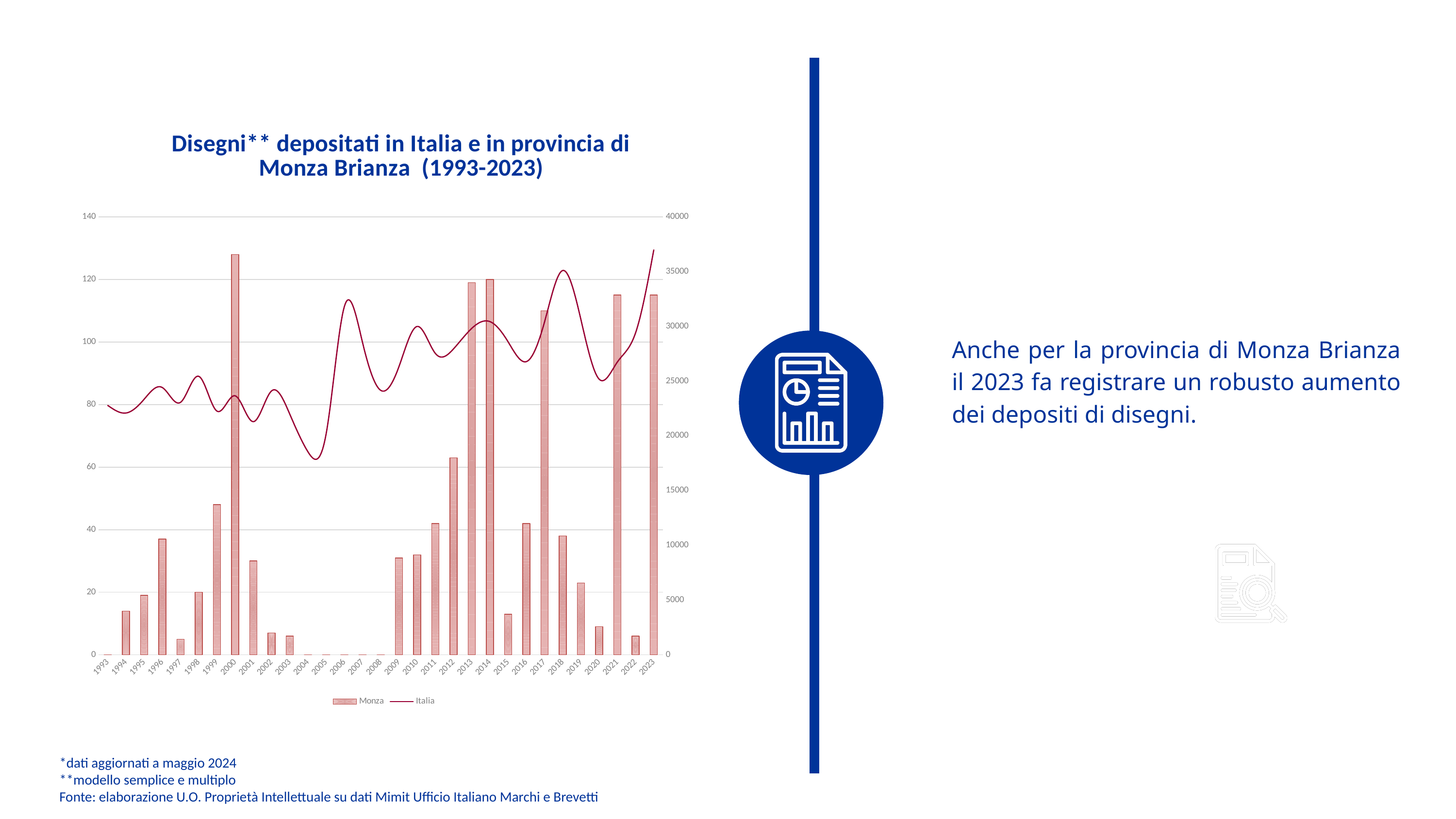
In which year does the Italia line reach its highest point? 2023 Is the Monza value for 2000 greater or less than 120? greater Is the Italia value for 2023 greater or less than 35000? greater How many series does the legend list? 2 In which year is the Monza bar the highest? 2000 Does the Italia line rise or fall from 2020 to 2023? Rise How many years are shown on the x axis? 31 Which two series are listed in the legend? Monza and Italia Which year has the larger Monza bar, 1996 or 2019? 1996 In which year does the Italia line reach its lowest point? 2004 What kind of chart is shown on the slide? A combined bar and line chart Is the Monza value for 2022 greater or less than 20? less